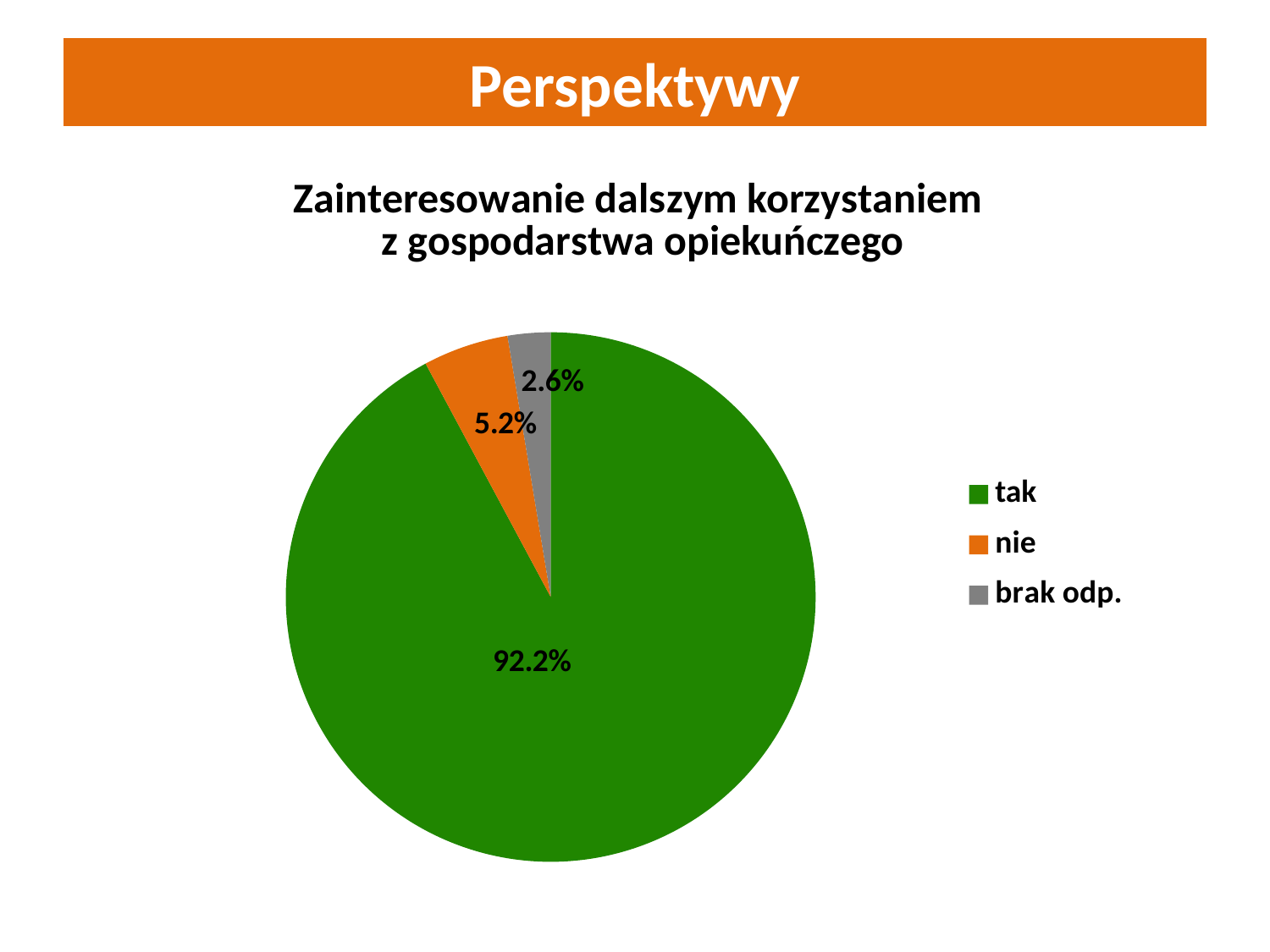
What is the share for "brak odp."? 2.6% Which category has the largest slice of the pie? tak What is the difference between the shares for "nie" and "brak odp."? 2.6% What kind of chart is shown on the slide? pie chart How many categories does the pie chart have? 3 What is the share for "nie"? 5.2% What colour is the slice for "nie"? orange What is the title of the chart? Zainteresowanie dalszym korzystaniem z gospodarstwa opiekuńczego Which is larger, the share for "nie" or the share for "brak odp."? nie Which category has the smallest slice of the pie? brak odp. What is the difference between the shares for "tak" and "nie"? 87.0% What is the share for "tak"? 92.2%